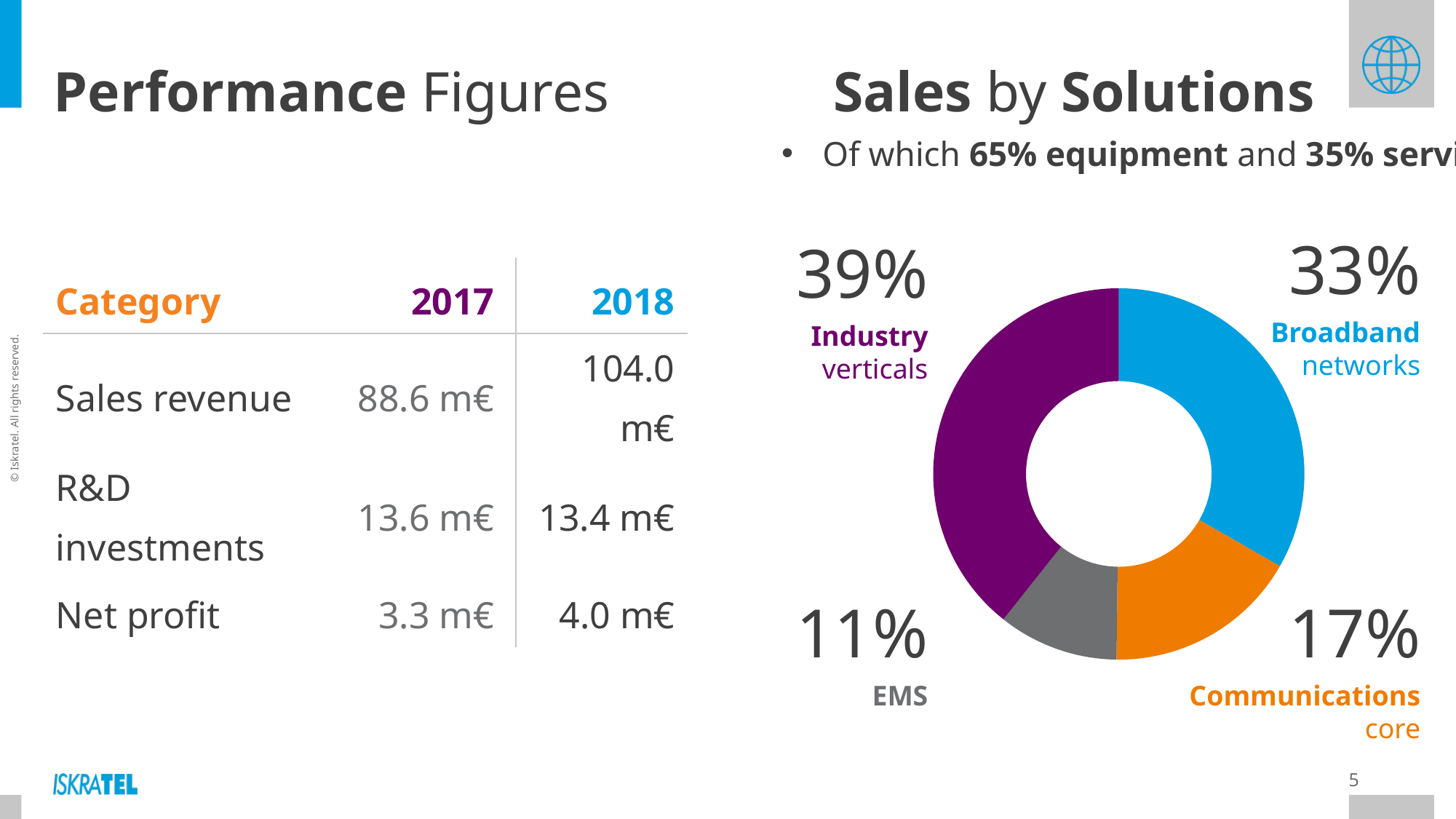
In the Sales by Solutions chart, what is the combined share of Communications core and EMS? 28% How many segments does the Sales by Solutions chart have? 4 In the Sales by Solutions chart, which is larger: Communications core or EMS? Communications core In the Sales by Solutions chart, what colour is the Broadband networks segment? Blue What kind of chart is shown under the 'Sales by Solutions' heading? Donut chart In the Sales by Solutions chart, what share of sales comes from Broadband networks? 33% Which segment of the Sales by Solutions chart has the smallest share? EMS In the Sales by Solutions chart, what share of sales comes from Communications core? 17% In the Sales by Solutions chart, what share of sales comes from Industry verticals? 39% In the Sales by Solutions chart, what is the difference in percentage points between Industry verticals and Broadband networks? 6 percentage points Which segment of the Sales by Solutions chart has the largest share? Industry verticals In the Sales by Solutions chart, what share of sales comes from EMS? 11%